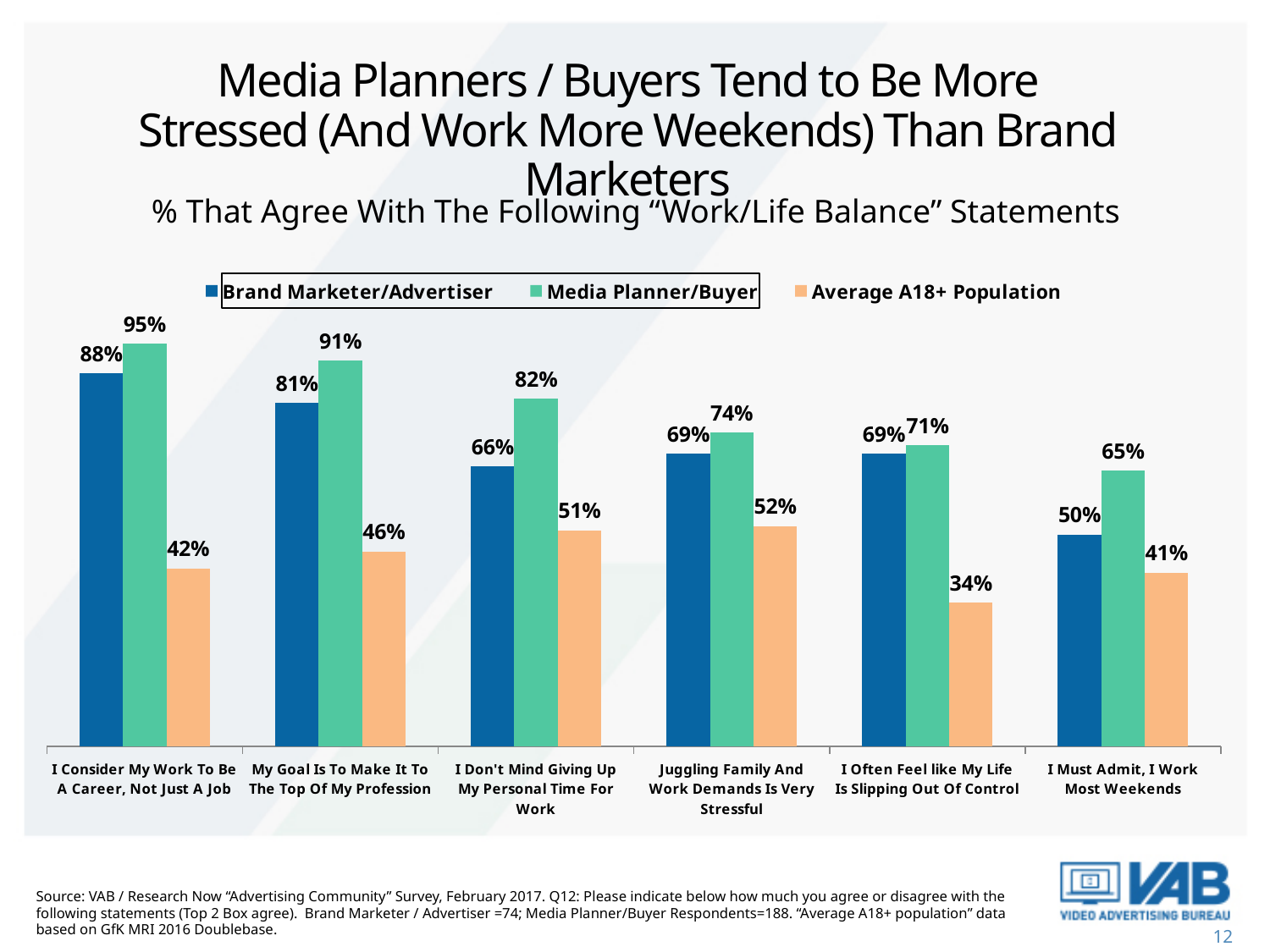
What is the difference between the Media Planner/Buyer and Brand Marketer/Advertiser values for "I Don't Mind Giving Up My Personal Time For Work"? 16% How many statements are shown on the x axis of the chart? 6 Which statement has the highest Media Planner/Buyer value? I Consider My Work To Be A Career, Not Just A Job What is the Average A18+ Population value for "I Often Feel like My Life Is Slipping Out Of Control"? 34% What kind of chart is shown on the slide? Bar chart Which series is shown in orange in the legend? Average A18+ Population How many series does the legend list? 3 What is the difference between the Media Planner/Buyer and Average A18+ Population values for "I Must Admit, I Work Most Weekends"? 24% What is the Brand Marketer/Advertiser value for "I Don't Mind Giving Up My Personal Time For Work"? 66% What percentage of Media Planner/Buyer respondents agree with "I Must Admit, I Work Most Weekends"? 65% Which statement has the lowest Average A18+ Population value? I Often Feel like My Life Is Slipping Out Of Control For "Juggling Family And Work Demands Is Very Stressful", which is larger: the Brand Marketer/Advertiser value or the Average A18+ Population value? Brand Marketer/Advertiser